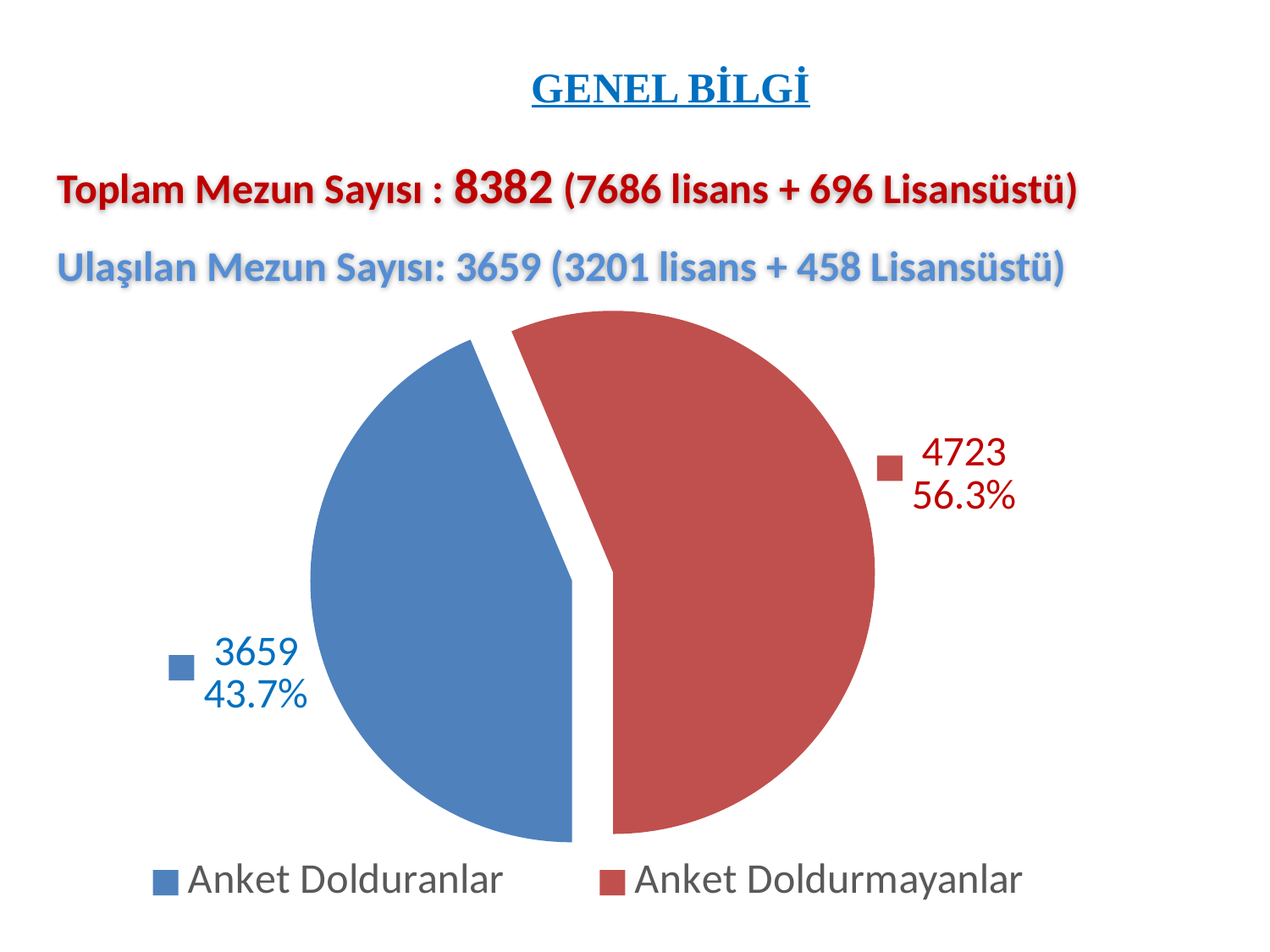
What is the difference between the values for Anket Doldurmayanlar and Anket Dolduranlar? 1064 What kind of chart is shown on the slide? pie chart Which is larger, Anket Dolduranlar or Anket Doldurmayanlar? Anket Doldurmayanlar Which slice is the largest? Anket Doldurmayanlar What is the total of the two slices in the pie chart? 8382 Which slice is the smallest? Anket Dolduranlar How many slices does the pie chart have? 2 What colour is the Anket Dolduranlar slice? blue What is the value for Anket Doldurmayanlar? 4723 What share of the pie does Anket Dolduranlar represent? 43.7% What share of the pie does Anket Doldurmayanlar represent? 56.3% What is the value for Anket Dolduranlar? 3659